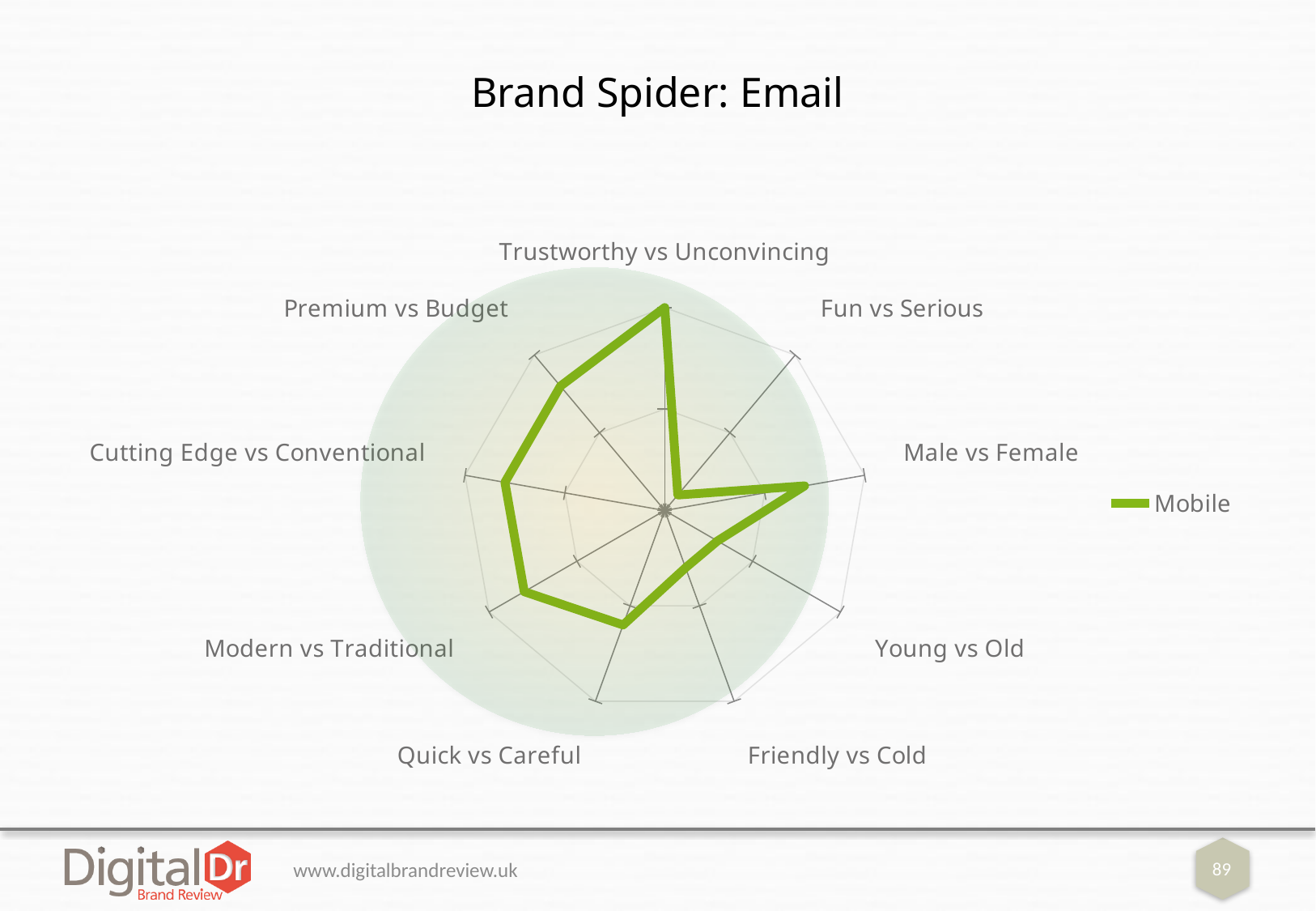
Which category has the lowest value for the Mobile series? Fun vs Serious Which has the larger value for Mobile: Premium vs Budget or Young vs Old? Premium vs Budget Which has the larger value for Mobile: Modern vs Traditional or Fun vs Serious? Modern vs Traditional How many series does the legend list? 1 Which has the larger value for Mobile: Cutting Edge vs Conventional or Young vs Old? Cutting Edge vs Conventional Which category has the highest value for the Mobile series? Trustworthy vs Unconvincing What is the name of the series shown in the legend? Mobile How many categories (axes) does the radar chart have? 9 What kind of chart is shown on the slide? Radar chart What is the title of the chart? Brand Spider: Email